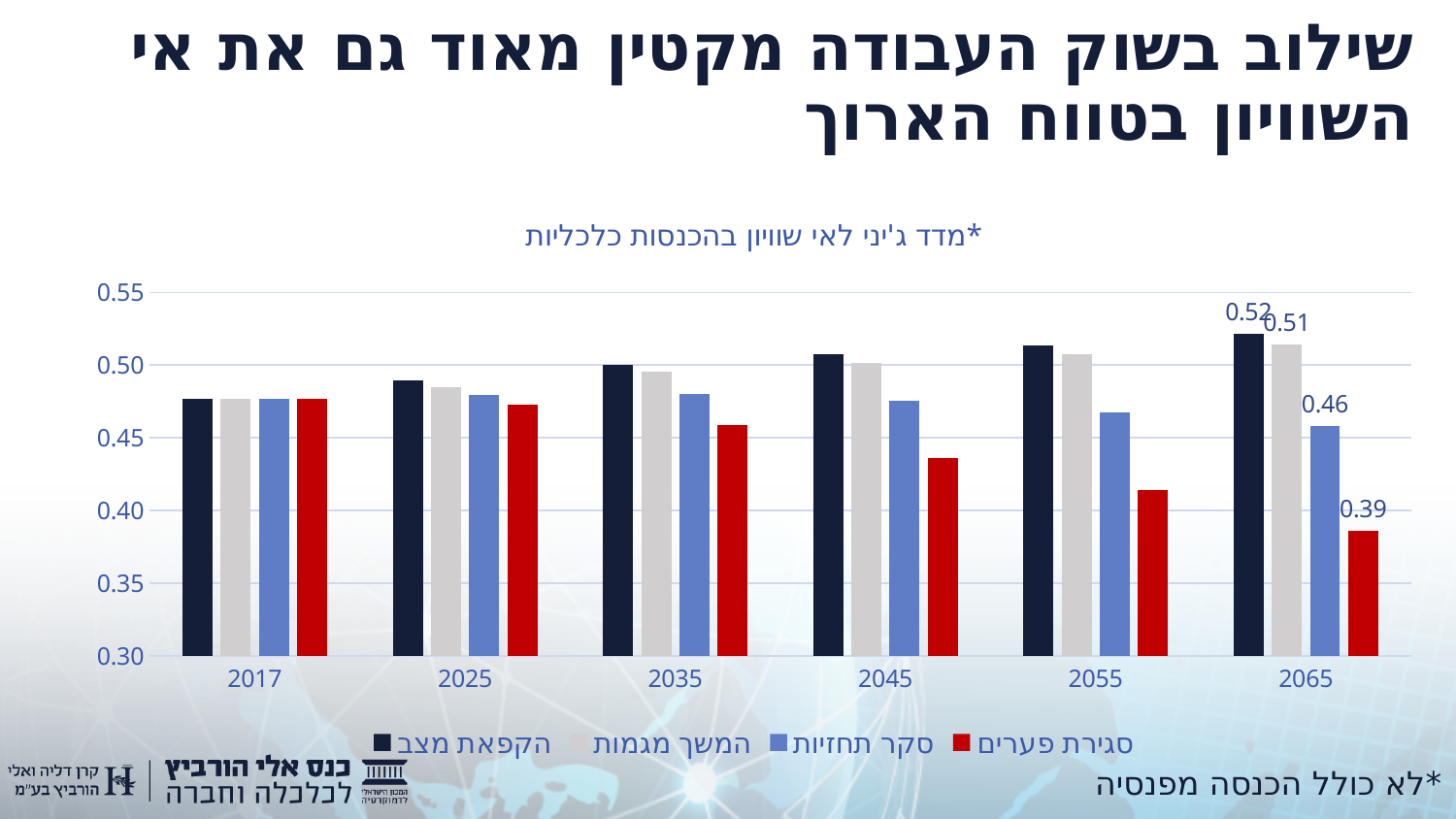
Which series has the highest value in 2065? הקפאת מצב Is the value for סגירת פערים in 2045 greater or less than 0.45? less In 2055, which is larger: the value for סקר תחזיות or the value for סגירת פערים? סקר תחזיות What is the value for המשך מגמות in 2065? 0.51 What is the value for סגירת פערים in 2065? 0.39 What is the value for הקפאת מצב in 2065? 0.52 Which series has the lowest value in 2065? סגירת פערים Does the value for סגירת פערים rise or fall from 2017 to 2065? fall What is the difference between the הקפאת מצב and סגירת פערים values in 2065? 0.13 What is the value for סקר תחזיות in 2065? 0.46 How many years are shown on the x axis? 6 How many series does the legend list? 4